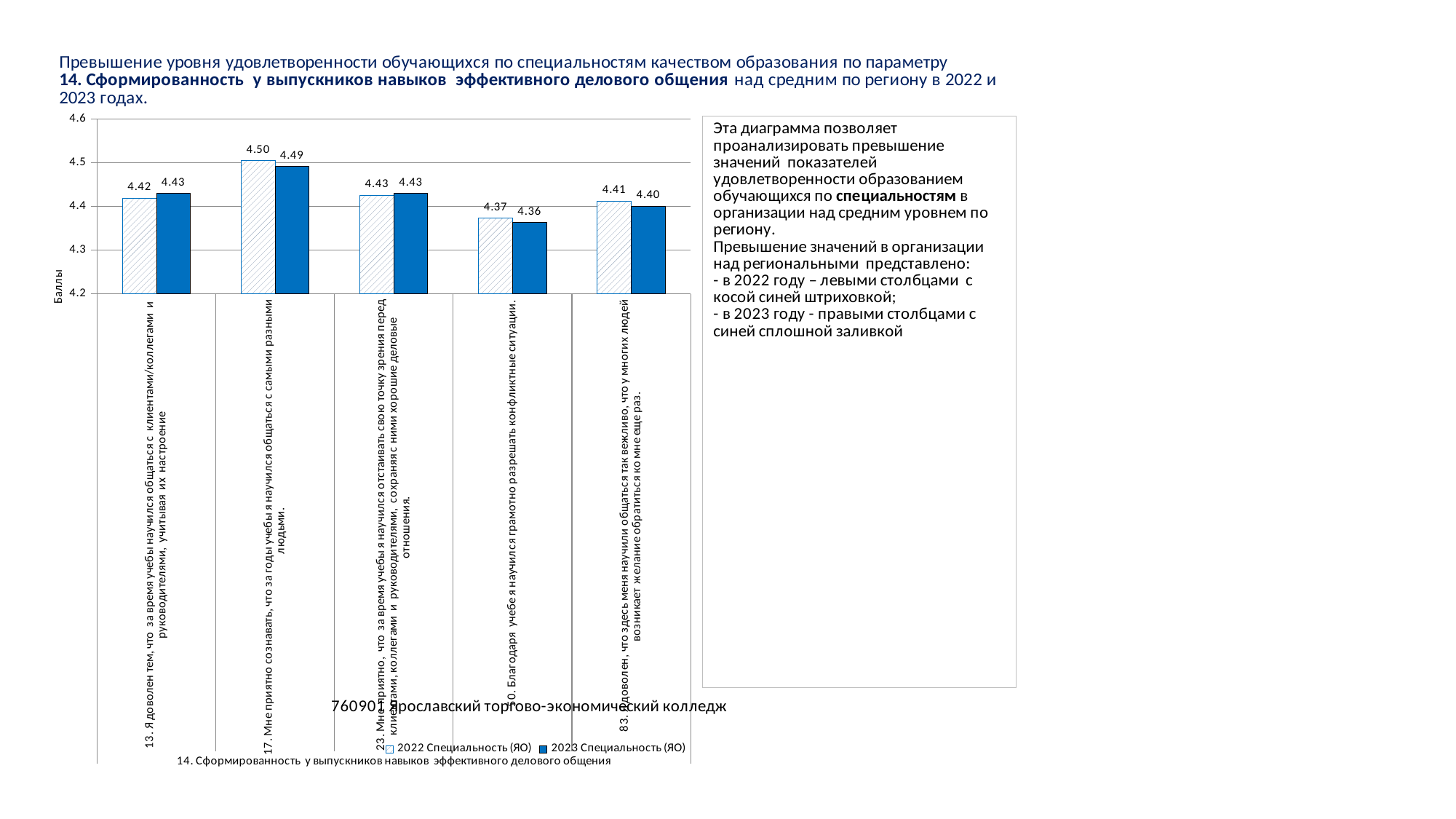
Какое значение у серии «2022 Специальность (ЯО)» для утверждения 83 («Я доволен, что здесь меня научили общаться так вежливо...»)? 4.41 Какое значение у серии «2023 Специальность (ЯО)» для утверждения 50 («Благодаря учебе я научился грамотно разрешать конфликтные ситуации»)? 4.36 На сколько значение 2022 года для утверждения 17 больше значения 2022 года для утверждения 50? 0.13 Какое значение у серии «2022 Специальность (ЯО)» для утверждения 17 («Мне приятно сознавать, что за годы учебы я научился общаться с самыми разными людьми»)? 4.50 Для какого утверждения значение серии «2023 Специальность (ЯО)» самое низкое? 50. Благодаря учебе я научился грамотно разрешать конфликтные ситуации. Какое значение больше для утверждения 13: 2022 года или 2023 года? 2023 года (4.43) Какое значение у серии «2023 Специальность (ЯО)» для утверждения 13 («Я доволен тем, что за время учебы научился общаться с клиентами/коллегами и руководителями...»)? 4.43 Сколько серий перечислено в легенде диаграммы? 2 Какого типа эта диаграмма? Столбчатая (bar chart) Значение 2023 года для утверждения 17 больше или меньше 4.4? больше Для какого утверждения значение серии «2022 Специальность (ЯО)» самое высокое? 17. Мне приятно сознавать, что за годы учебы я научился общаться с самыми разными людьми. Сколько утверждений (категорий) показано на диаграмме? 5